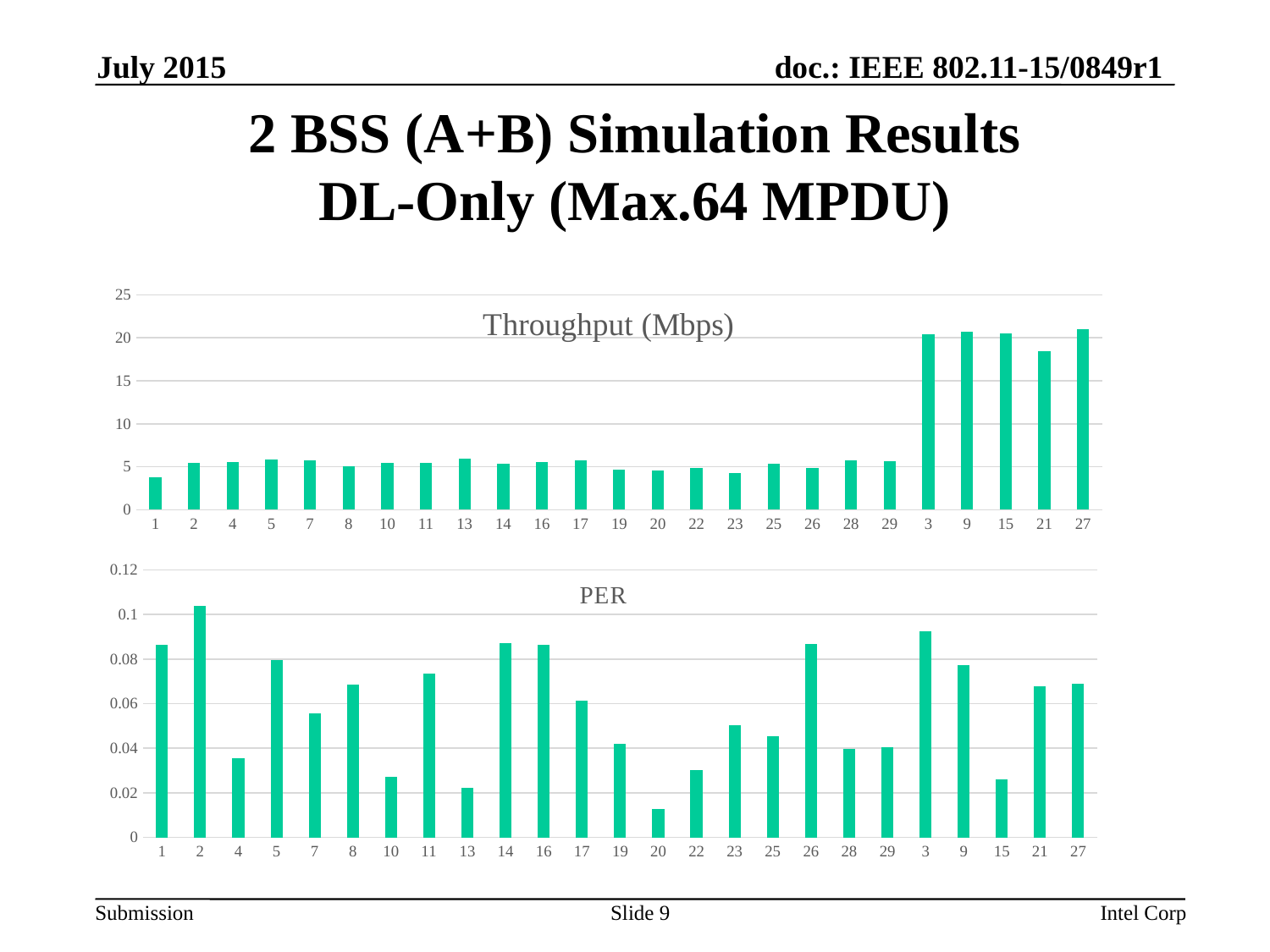
In the Throughput (Mbps) chart, is the value for category 3 greater or less than 15? greater In the PER chart, which is larger, the value for category 2 or the value for category 4? 2 In the PER chart, is the value for category 2 greater or less than 0.1? greater What kind of chart is the Throughput (Mbps) chart? bar chart In the Throughput (Mbps) chart, which category has the lowest value? 1 How many categories are plotted in the PER chart? 25 In the PER chart, is the value for category 13 greater or less than 0.04? less In the PER chart, which category has the highest value? 2 In the Throughput (Mbps) chart, which is larger, the value for category 27 or the value for category 29? 27 In the PER chart, which category has the lowest value? 20 What is the title of the top chart on the slide? Throughput (Mbps)